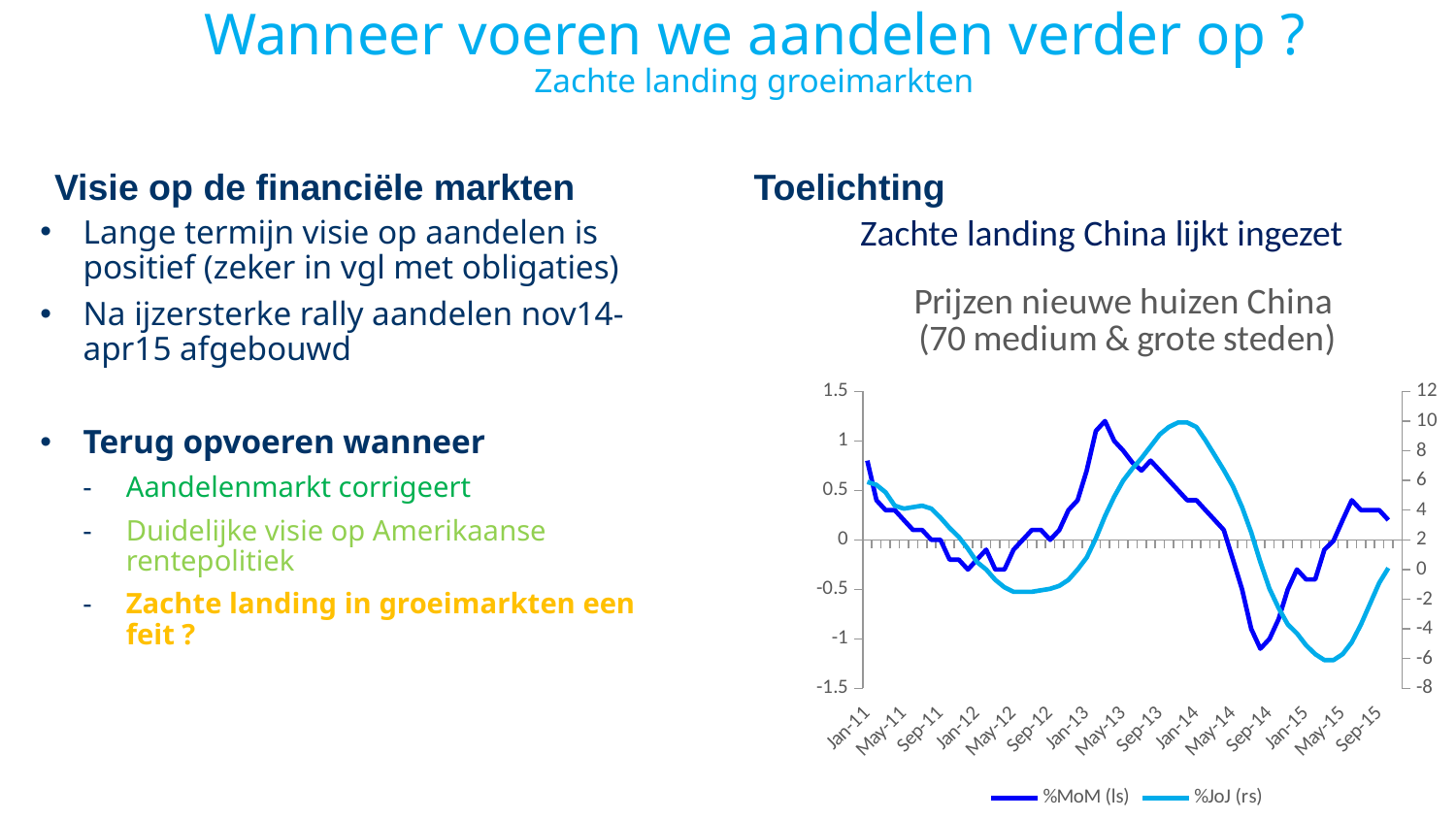
What is the title of the chart? Prijzen nieuwe huizen China (70 medium & grote steden) How many series does the chart legend list? 2 Does the %JoJ (rs) line rise or fall between Jan-14 and May-15? fall Is the peak of the %MoM (ls) line in early 2013 greater or less than 1? greater Is the %MoM (ls) value at Jan-11 greater or less than 0.5? greater Is the %MoM (ls) value at Sep-15 greater or less than 0? greater What kind of chart is shown on the slide? line chart Does the %MoM (ls) line rise or fall between Sep-12 and early 2013? rise Which two series are listed in the chart legend? %MoM (ls) and %JoJ (rs)